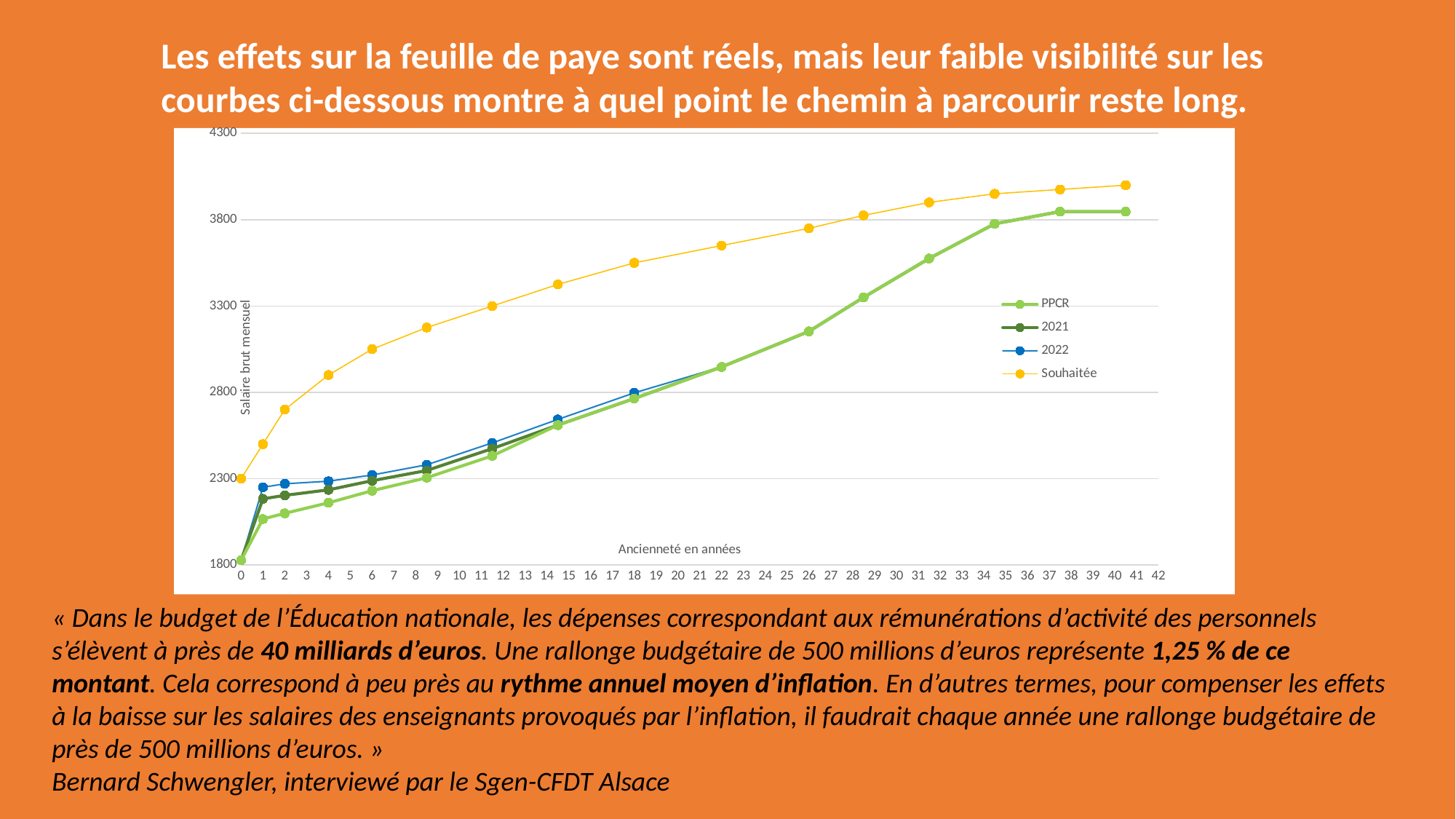
What is the label of the vertical axis of the chart? Salaire brut mensuel Is the PPCR value at 0 years of ancienneté greater or less than 2300? less How many series does the chart legend list? 4 Is the Souhaitée value at 40 years of ancienneté greater or less than 3800? greater What kind of chart is shown on the slide? line chart Which series has the lowest value at 4 years of ancienneté? PPCR Does the Souhaitée series rise or fall as ancienneté increases along the x axis? rise Is the PPCR value at 22 years of ancienneté greater or less than 2800? greater Which series has the highest value at 26 years of ancienneté? Souhaitée What are the series names listed in the chart legend? PPCR, 2021, 2022, Souhaitée At 1 year of ancienneté, which is larger: the 2022 value or the PPCR value? 2022